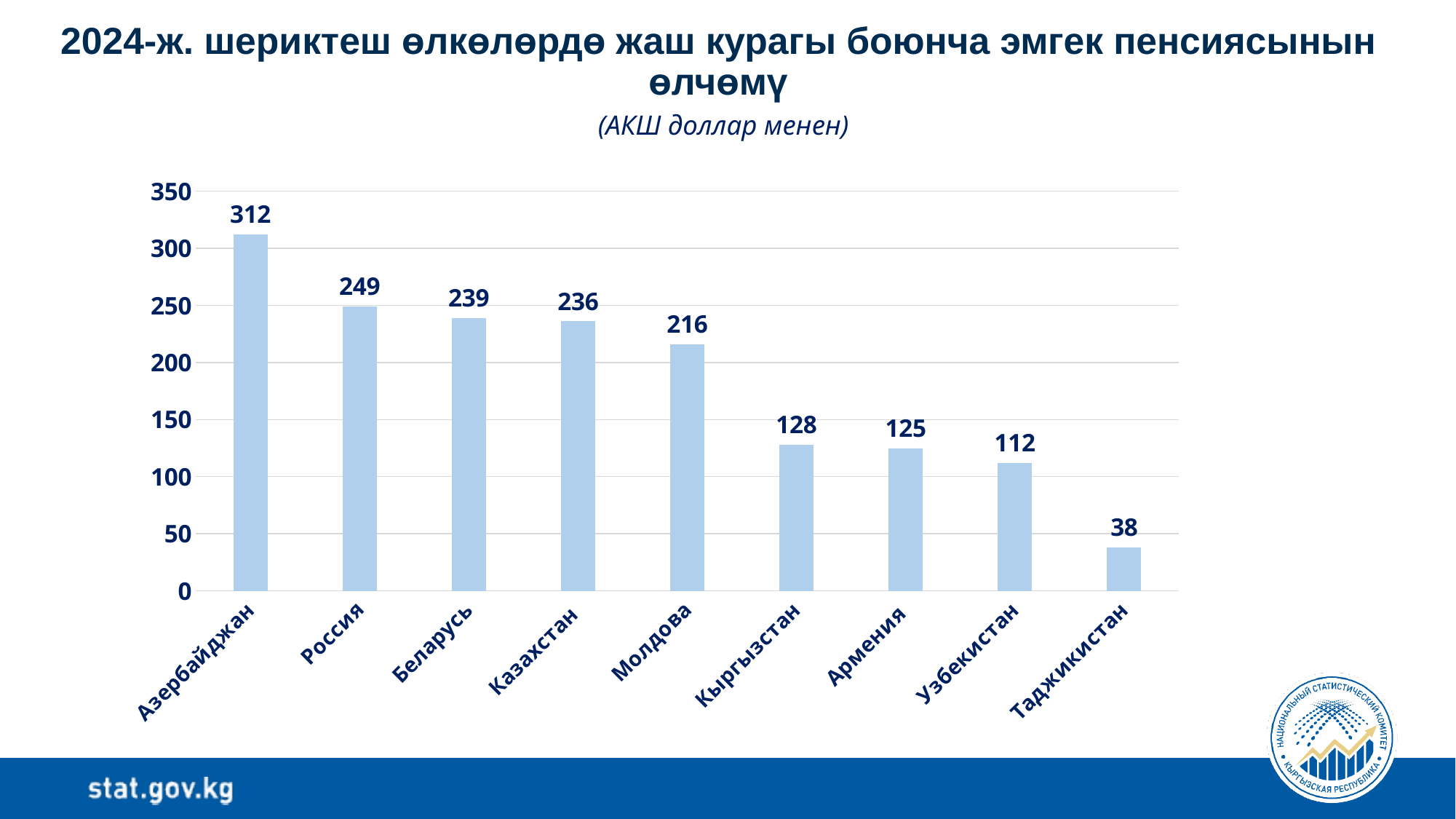
Is the value for Казахстан greater or less than 200? greater What is the value for Россия? 249 What is the difference between the values for Азербайджан and Россия? 63 Which country has the highest value? Азербайджан Do the values rise or fall from left to right along the x axis? fall What kind of chart is shown on the slide? bar chart What is the value for Таджикистан? 38 Which country has the lowest value? Таджикистан Which is larger, the value for Молдова or the value for Узбекистан? Молдова How many countries are shown on the chart? 9 What is the difference between the values for Кыргызстан and Армения? 3 What is the value for Кыргызстан? 128